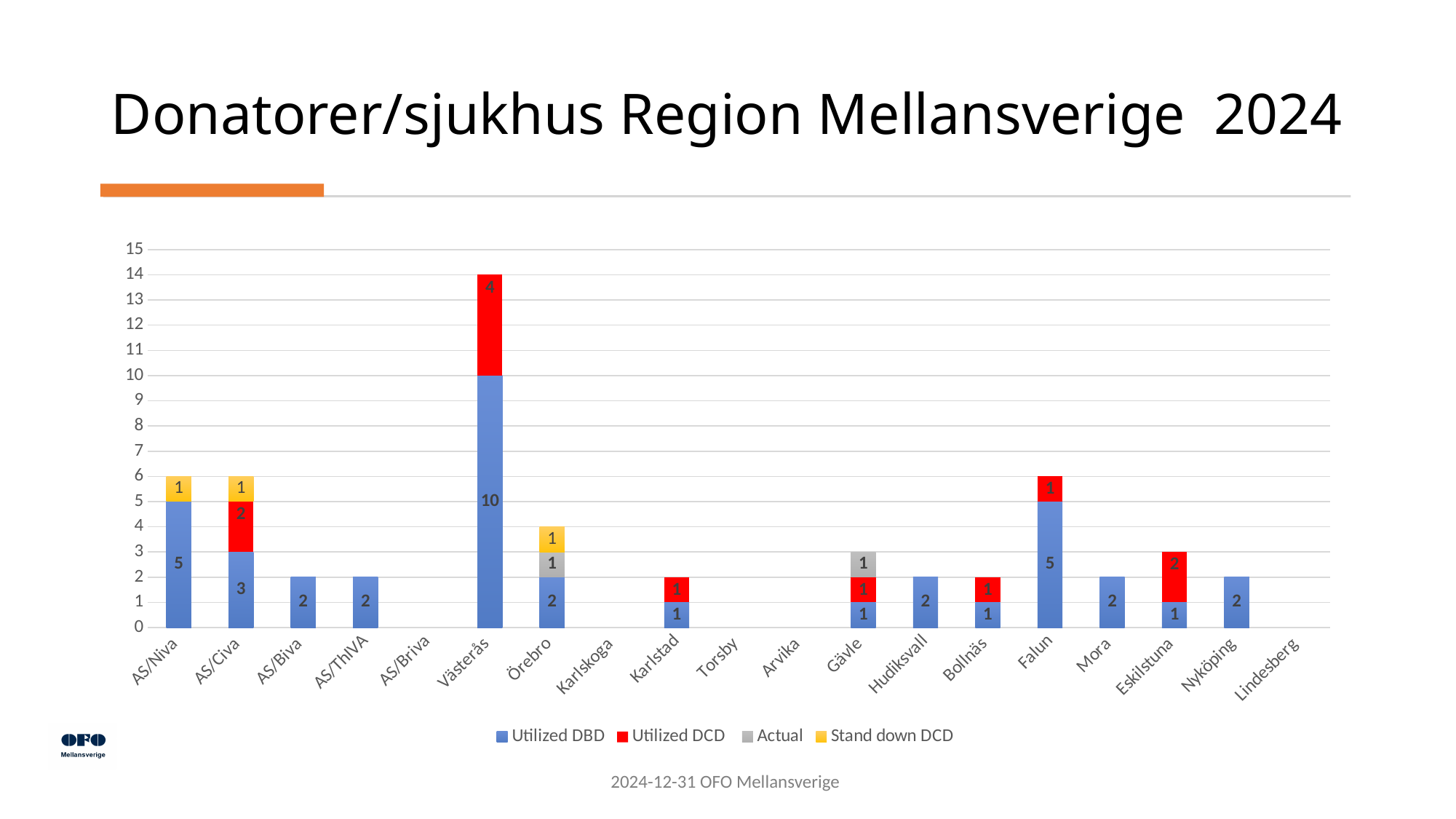
Which hospital has the highest total bar? Västerås What is the Stand down DCD value for Örebro? 1 What is the total of the stacked bar for Västerås? 14 Which series is shown in grey in the legend? Actual How many hospital categories are shown on the x axis? 19 What is the difference between the Utilized DBD values for Västerås and Falun? 5 What is the Utilized DBD value for Västerås? 10 What is the Utilized DCD value for Eskilstuna? 2 What is the total of the stacked bar for AS/Civa? 6 Which has a larger Utilized DBD value, AS/Niva or AS/Civa? AS/Niva What type of chart is shown on the slide? Stacked bar chart How many series does the legend list? 4